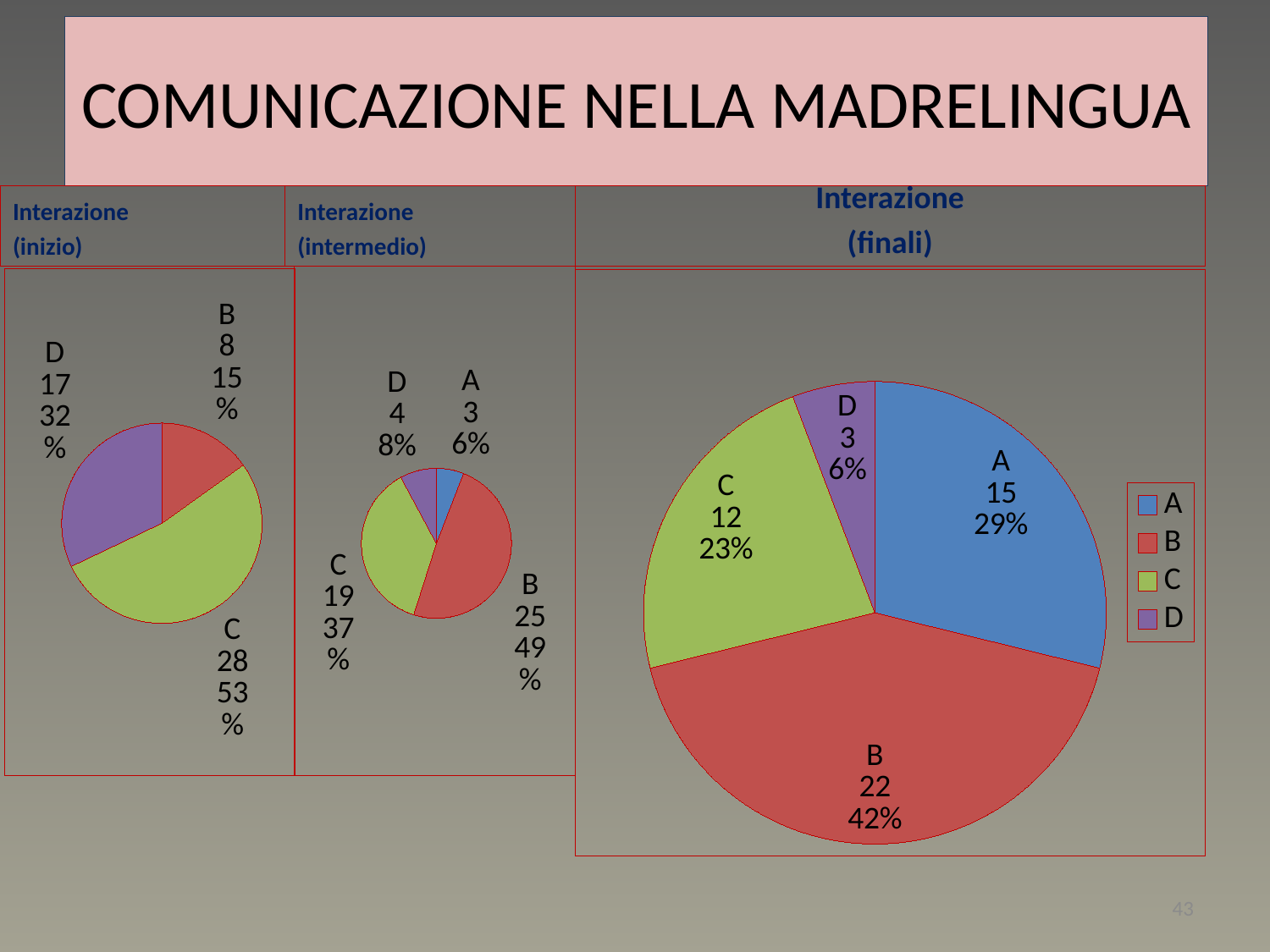
In the 'Interazione (finali)' pie chart, which category has the largest value? B In the 'Interazione (intermedio)' pie chart, which is larger, the value for C or the value for D? C What kind of chart is used for 'Interazione (inizio)'? Pie chart In the 'Interazione (intermedio)' pie chart, which category has the smallest value? A In the 'Interazione (inizio)' pie chart, what value is shown for category C? 28 How many entries does the legend of the 'Interazione (finali)' chart list? 4 In the 'Interazione (finali)' pie chart, what value is shown for category B? 22 In the 'Interazione (finali)' pie chart, what is the difference between the values for B and C? 10 In the 'Interazione (intermedio)' pie chart, what percentage share does category B have? 49% In the 'Interazione (finali)' pie chart, what colour is the slice for category D? Purple In the 'Interazione (finali)' pie chart, what percentage share does category A have? 29% In the 'Interazione (inizio)' pie chart, which category has the largest share? C